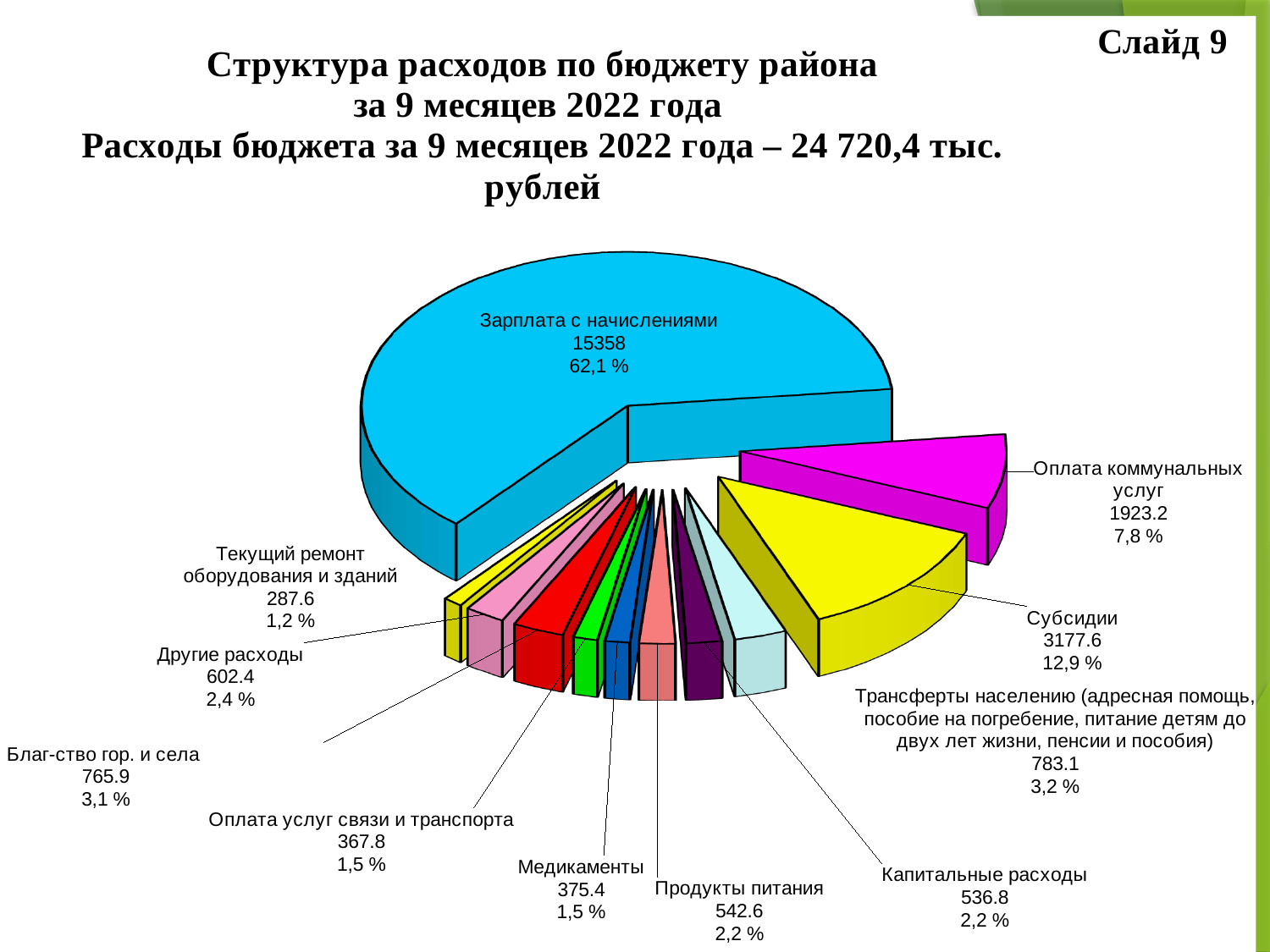
Which is larger, the value for Благ-ство гор. и села or the value for Другие расходы? Благ-ство гор. и села What total budget expenditure for 9 months of 2022 is stated in the slide title? 24 720,4 тыс. рублей What share of the pie does Субсидии represent? 12,9 % What kind of chart is shown on the slide? Pie chart Which category has the largest slice of the pie? Зарплата с начислениями What share of the pie does Капитальные расходы represent? 2,2 % What is the value shown for Зарплата с начислениями? 15358 Which category has the smallest slice of the pie? Текущий ремонт оборудования и зданий What is the difference between the values for Субсидии and Оплата коммунальных услуг? 1254.4 What is the value shown for Медикаменты? 375.4 What is the value shown for Оплата коммунальных услуг? 1923.2 How many slices does the pie chart have? 11